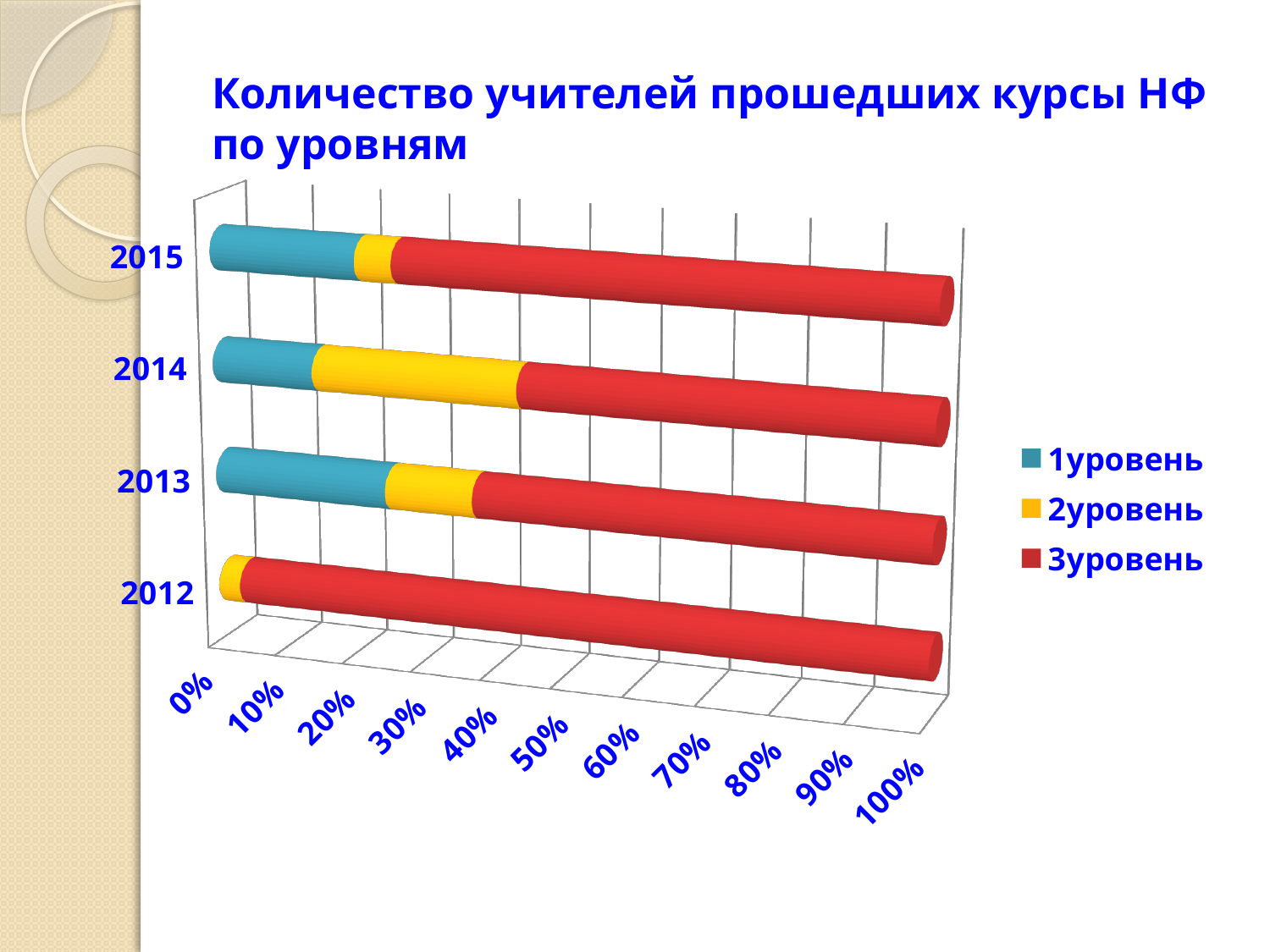
Is the share of 2уровень for 2015 greater or less than 10%? less Is the share of 2уровень for 2012 greater or less than 10%? less What is the title of the chart? Количество учителей прошедших курсы НФ по уровням Which year has the smallest share of 3уровень? 2014 Which is larger, the share of 2уровень in 2014 or in 2015? 2014 Which series is shown in red in the legend? 3уровень How many years (categories) are shown on the chart? 4 Is the share of 3уровень for 2014 greater or less than 50%? greater How many series does the legend list? 3 What kind of chart is shown on the slide? stacked bar chart Which year has the largest share of 2уровень? 2014